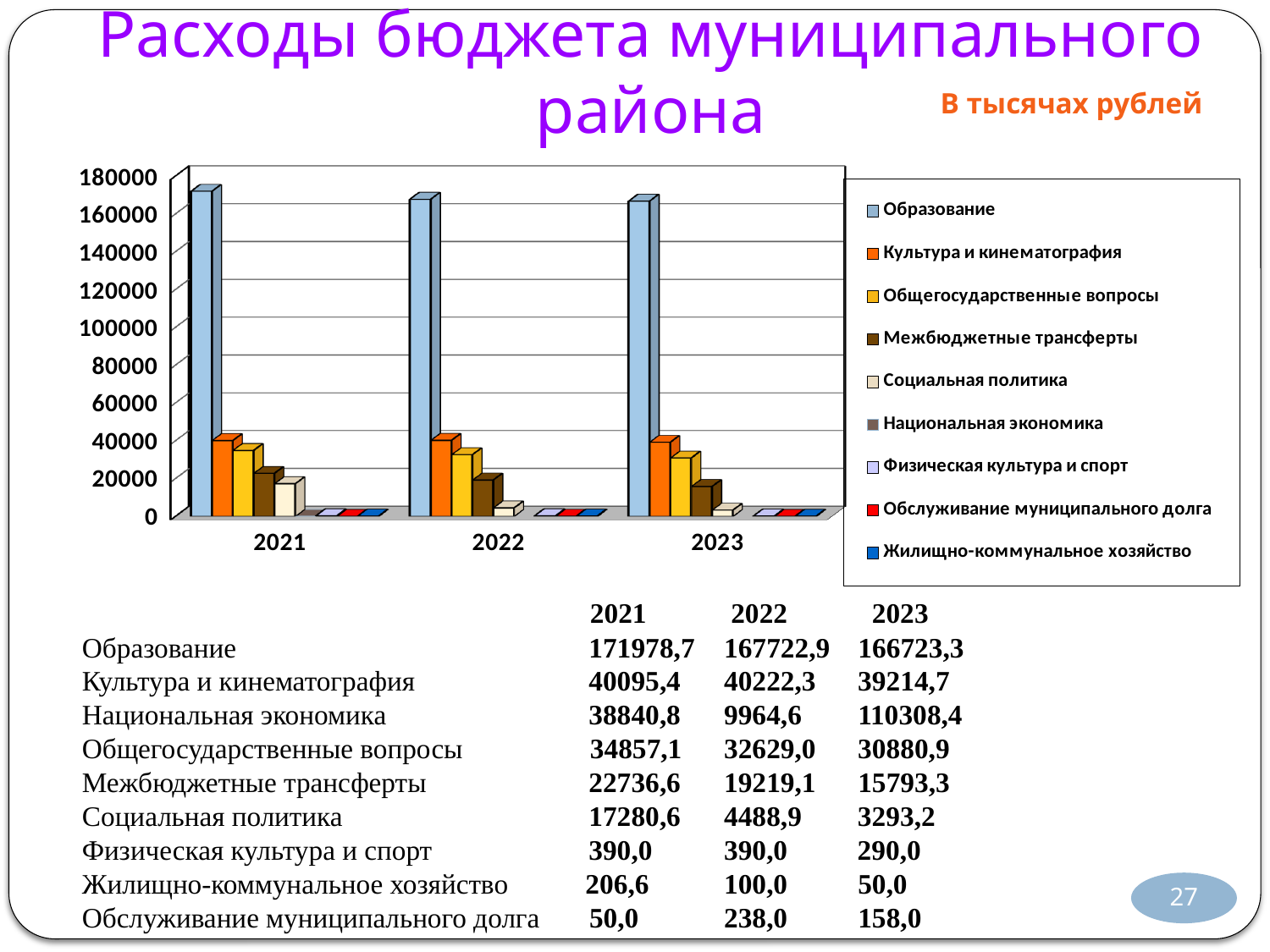
What is the value for Социальная политика in 2022? 4488,9 In 2021, which is larger: Культура и кинематография or Общегосударственные вопросы? Культура и кинематография Do the values for Образование rise or fall from 2021 to 2023? fall Is the value for Образование in 2023 greater or less than 160000? greater In what units are the chart values given, according to the slide? В тысячах рублей What kind of chart is shown on the slide? bar chart Which series has the highest value in 2022? Образование What is the value for Образование in 2021? 171978,7 What is the difference between the Межбюджетные трансферты values for 2021 and 2023? 6943,3 How many series does the chart legend list? 9 What is the value for Культура и кинематография in 2023? 39214,7 How many years are shown along the x axis of the chart? 3